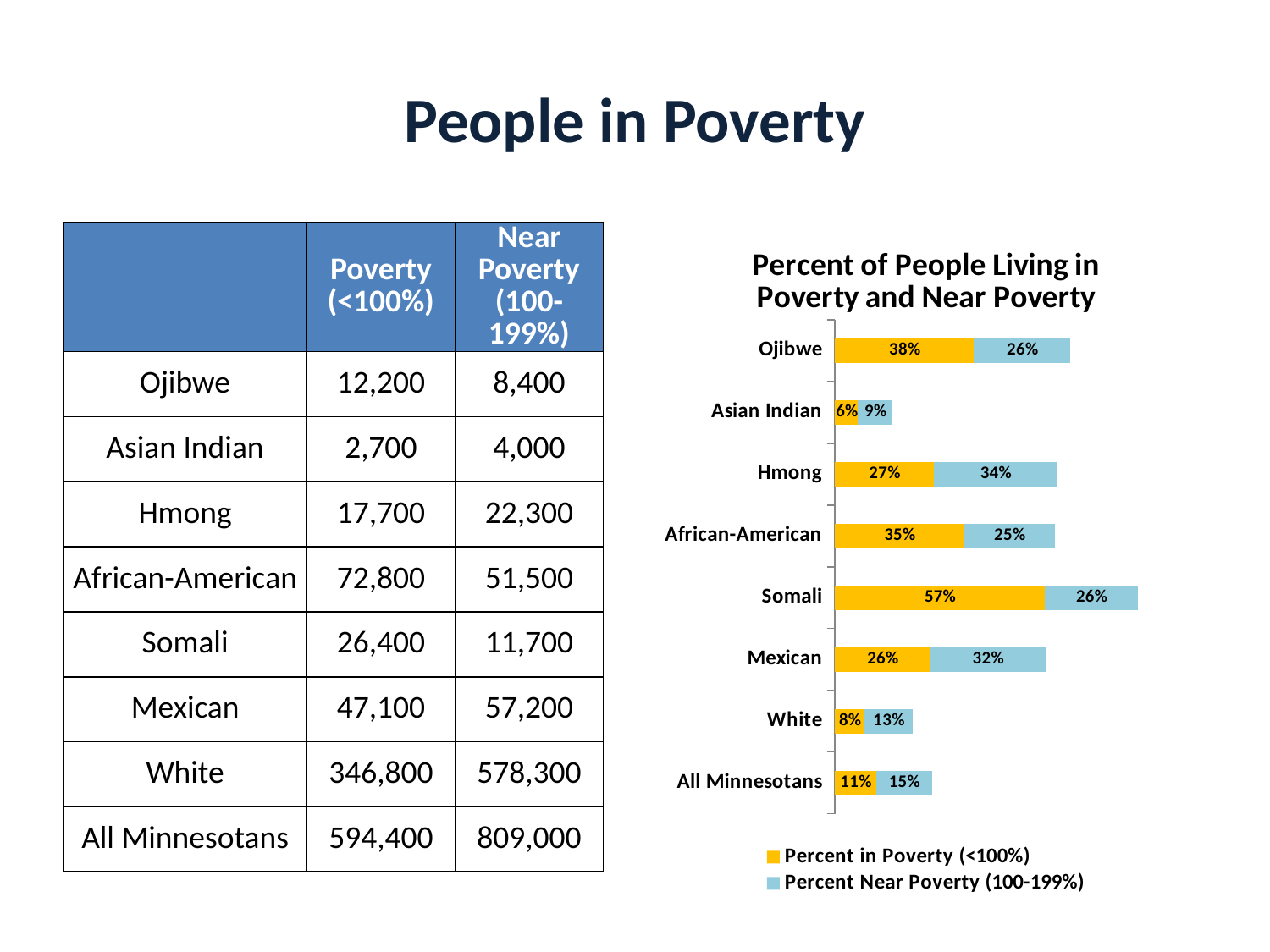
In the chart, what is the Percent in Poverty (<100%) for Somali? 57% How many groups are shown in the chart? 8 What is the difference between the Percent in Poverty for Ojibwe and for White? 30% In the chart, what is the Percent Near Poverty (100-199%) for Hmong? 34% Which group has the highest Percent Near Poverty (100-199%) in the chart? Hmong What type of chart is shown on the slide? Stacked bar chart What is the combined percent of people living in poverty and near poverty for Somali? 83% How many series does the chart legend list? 2 Which group has the highest Percent in Poverty (<100%) in the chart? Somali Which is larger: the Percent in Poverty for African-American or for Mexican? African-American Which group has the lowest Percent in Poverty (<100%) in the chart? Asian Indian In the chart, what is the Percent in Poverty (<100%) for All Minnesotans? 11%